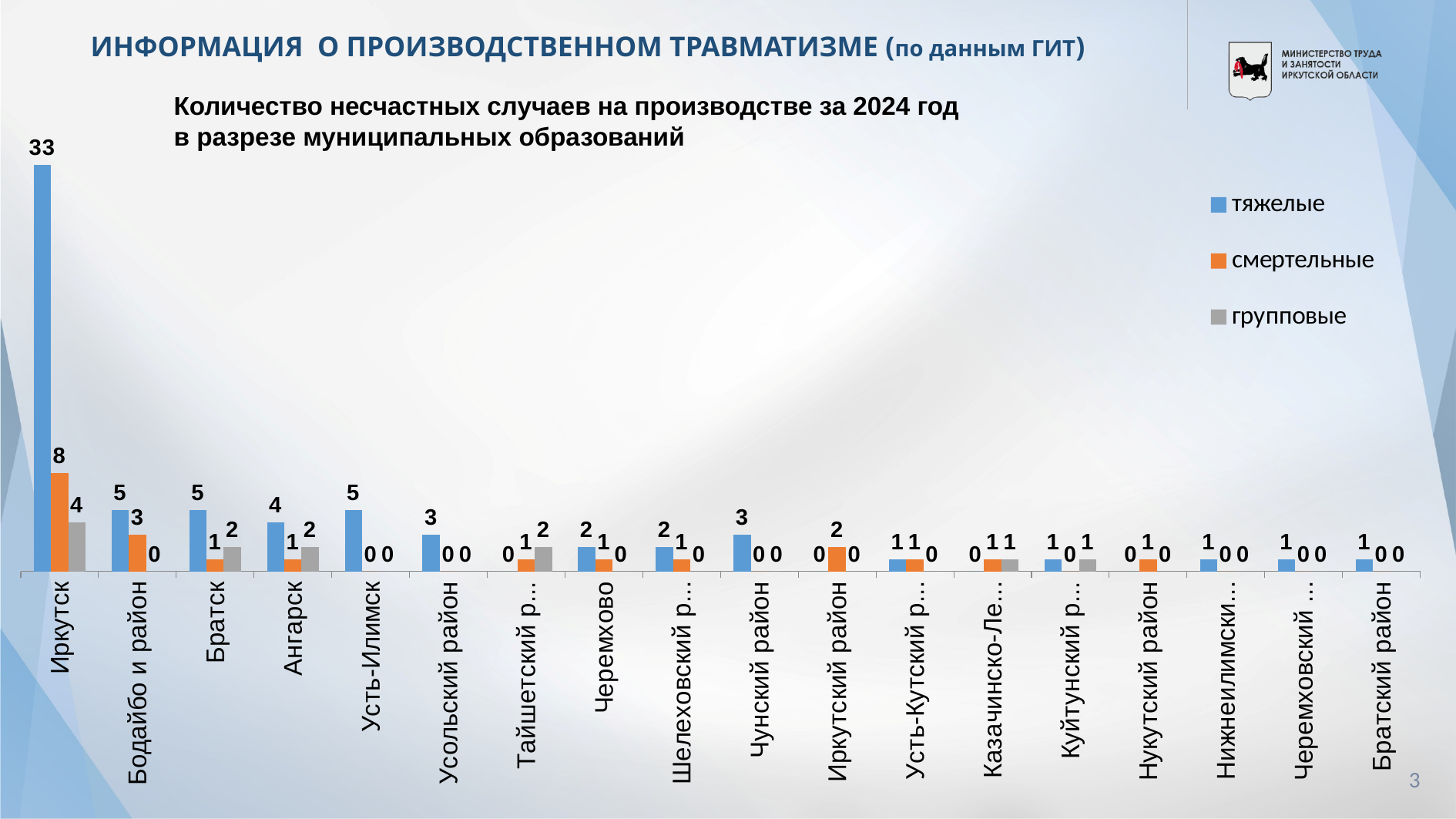
What is the value for тяжелые in Иркутск? 33 What is the value for смертельные in Иркутский район? 2 What is the value for смертельные in Бодайбо и район? 3 What is the value for групповые in Ангарск? 2 What is the value for тяжелые in Чунский район? 3 How many municipalities are shown on the x axis? 18 Which series is shown in orange in the legend? смертельные Which is larger: the тяжелые value for Усть-Илимск or the тяжелые value for Усольский район? Усть-Илимск How many series does the legend list? 3 What is the difference between the тяжелые and смертельные values for Иркутск? 25 Which municipality has the highest value for тяжелые? Иркутск What kind of chart is shown on the slide? Bar chart